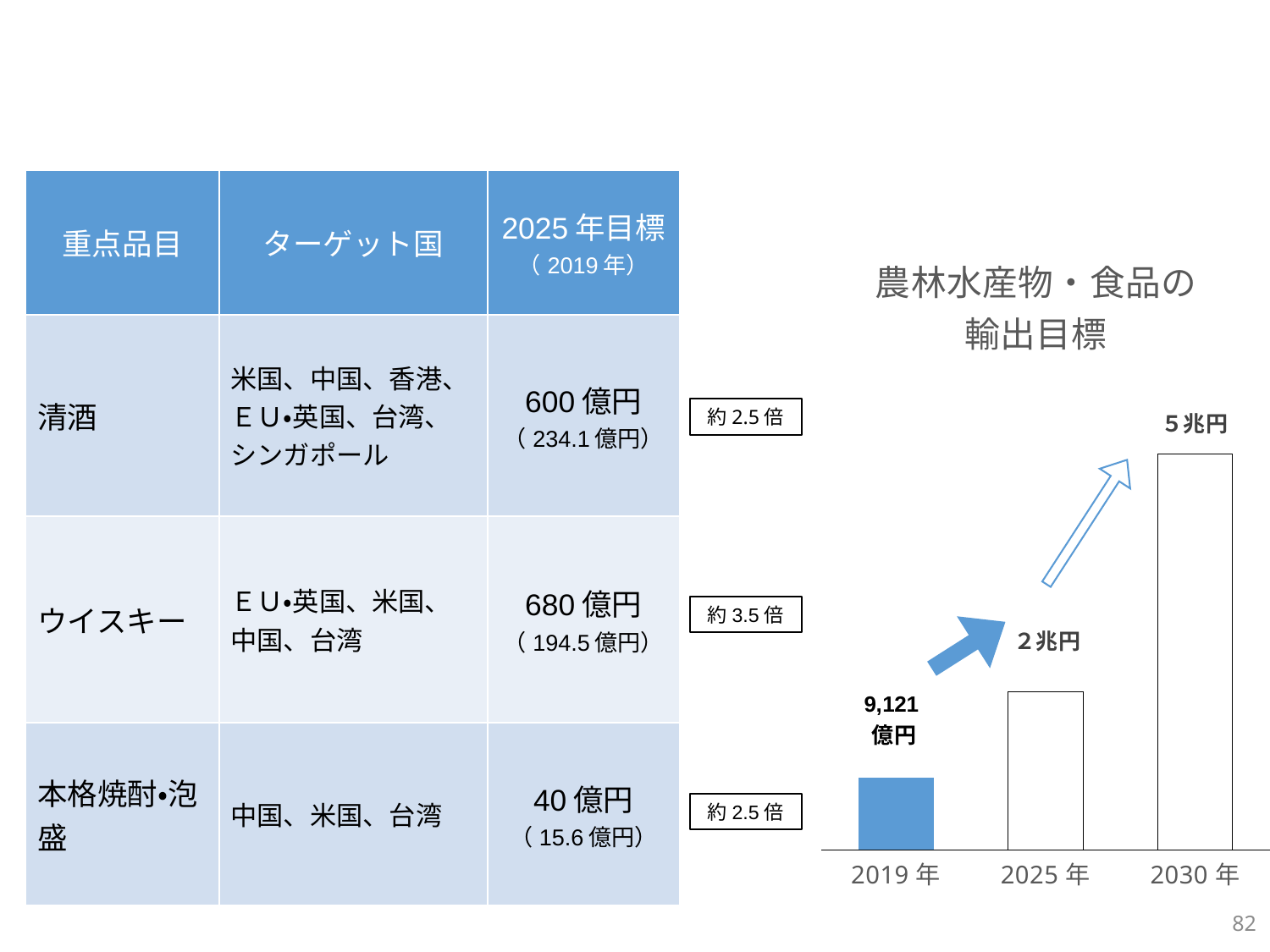
What is the value shown for 2030年 in the 農林水産物・食品の輸出目標 chart? 5兆円 What is the value shown for 2019年 in the 農林水産物・食品の輸出目標 chart? 9,121億円 How many years (bars) are shown in the 農林水産物・食品の輸出目標 chart? 3 What is the title of the chart on the right side of the slide? 農林水産物・食品の輸出目標 Which year has the highest value in the 農林水産物・食品の輸出目標 chart? 2030年 In the 農林水産物・食品の輸出目標 chart, which is larger, the value for 2025年 or the value for 2030年? 2030年 Do the values in the 農林水産物・食品の輸出目標 chart rise or fall from 2019年 to 2030年? Rise Which year has the lowest value in the 農林水産物・食品の輸出目標 chart? 2019年 What kind of chart is the 農林水産物・食品の輸出目標 chart? Bar chart What is the value shown for 2025年 in the 農林水産物・食品の輸出目標 chart? 2兆円 In the 農林水産物・食品の輸出目標 chart, what is the difference between the 2030年 value and the 2025年 value? 3兆円 In the 農林水産物・食品の輸出目標 chart, which bar is filled in blue rather than drawn as a white outline? 2019年